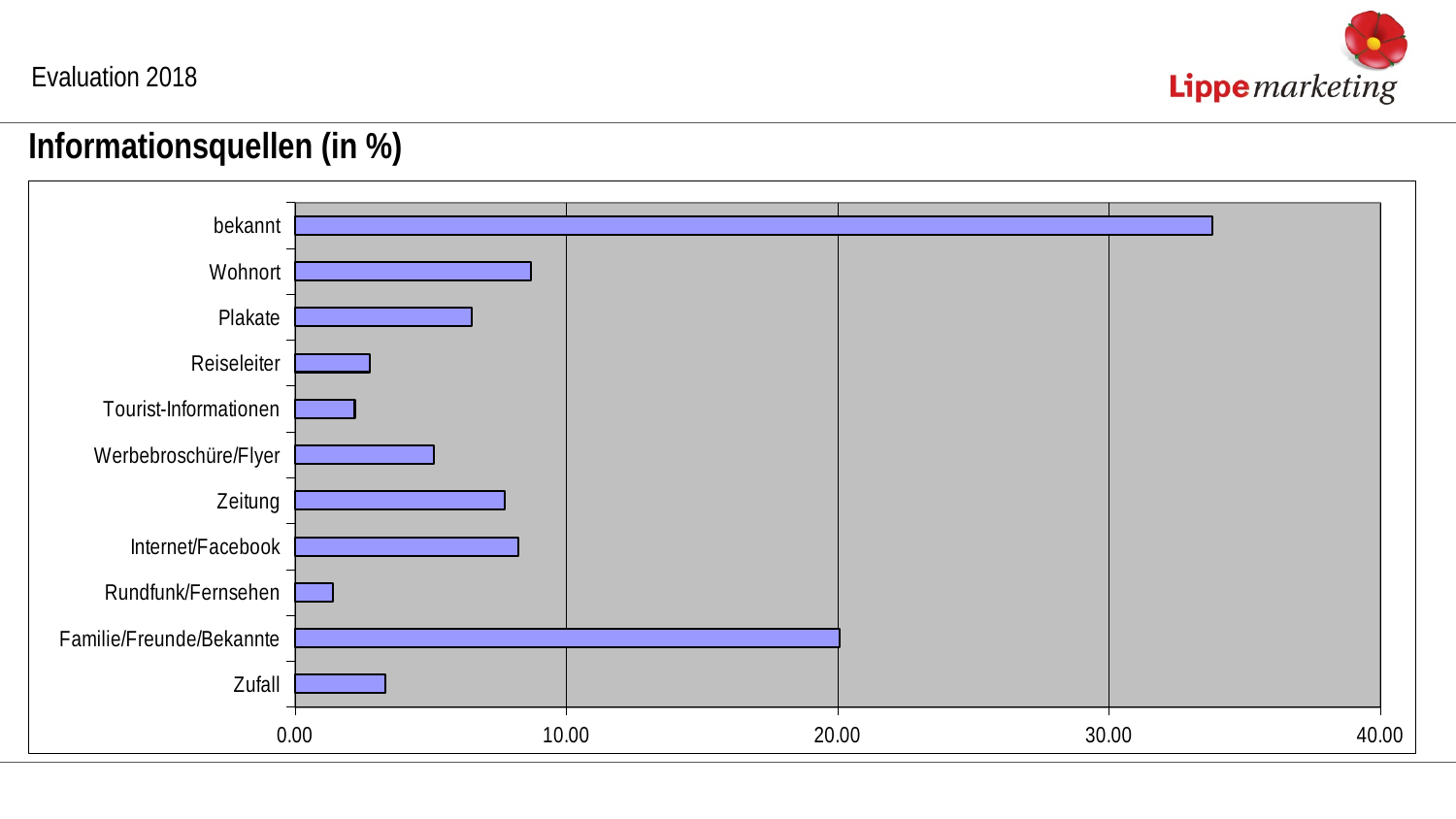
Is the value for bekannt greater or less than 30? greater Is the value for Wohnort greater or less than 10? less What is the title of the chart on the slide? Informationsquellen (in %) Which is larger, the value for Wohnort or the value for Plakate? Wohnort Which category has the highest value? bekannt Which is larger, the value for bekannt or the value for Familie/Freunde/Bekannte? bekannt How many categories are shown in the chart? 11 Which category has the lowest value? Rundfunk/Fernsehen Is the value for Zufall greater or less than 10? less Which is larger, the value for Reiseleiter or the value for Rundfunk/Fernsehen? Reiseleiter What kind of chart is shown on the slide? bar chart